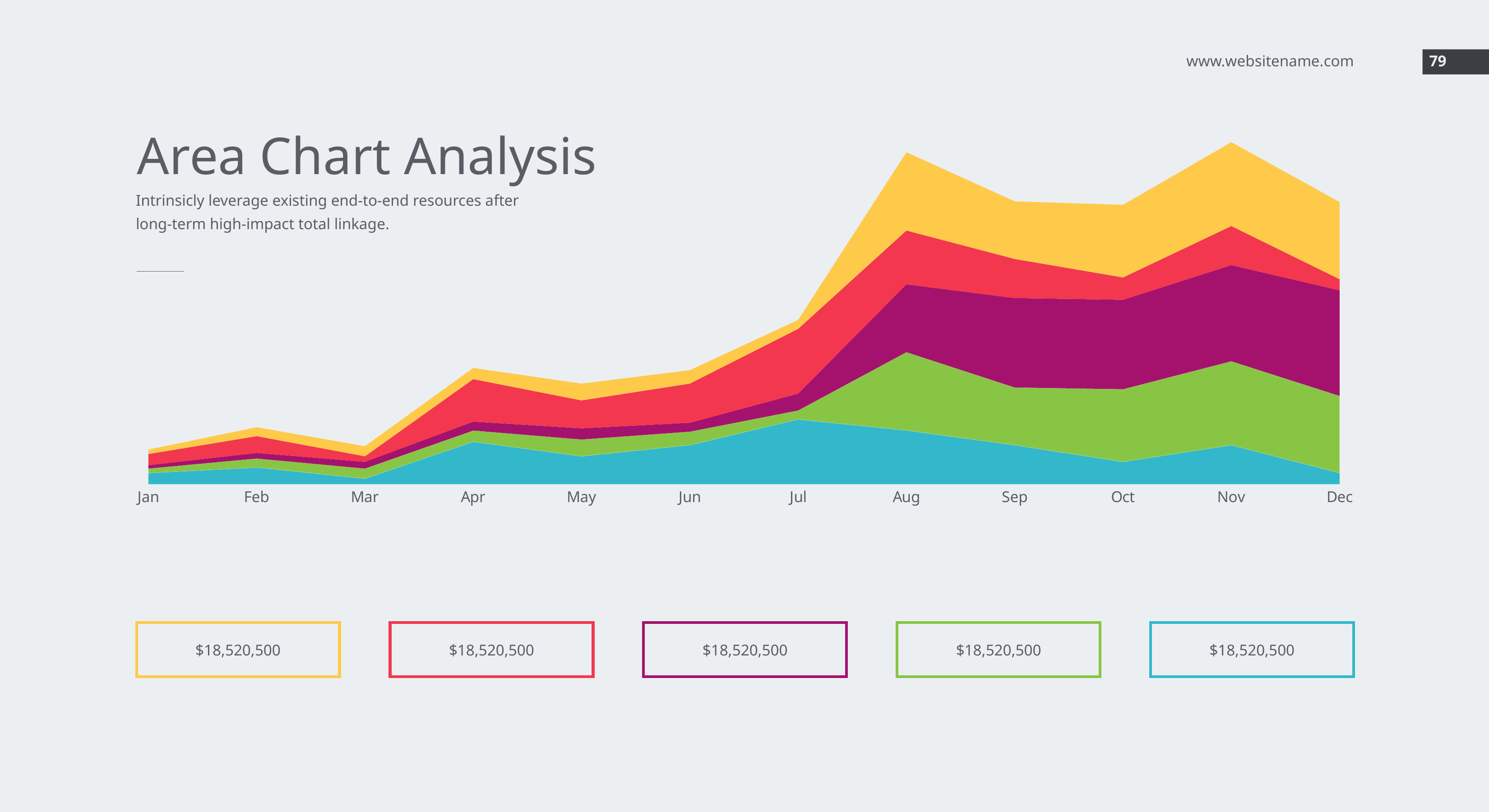
Which month has the highest total stacked value in the area chart? Nov Is the total stacked value larger in Aug or in Jul? Aug What is the title of the slide containing the area chart? Area Chart Analysis In which month does the blue (bottom) series reach its highest value? Jul Does the total stacked value generally rise or fall from Jan to Aug? Rise How many months are shown along the x axis of the area chart? 12 What colour is the topmost series in the stacked area chart? Yellow In which month does the green series reach its highest value? Nov Does the total stacked value rise or fall from Aug to Oct? Fall What kind of chart is shown on the slide? Area chart Is the total stacked value larger in Feb or in Mar? Feb How many coloured series are stacked in the area chart? 5